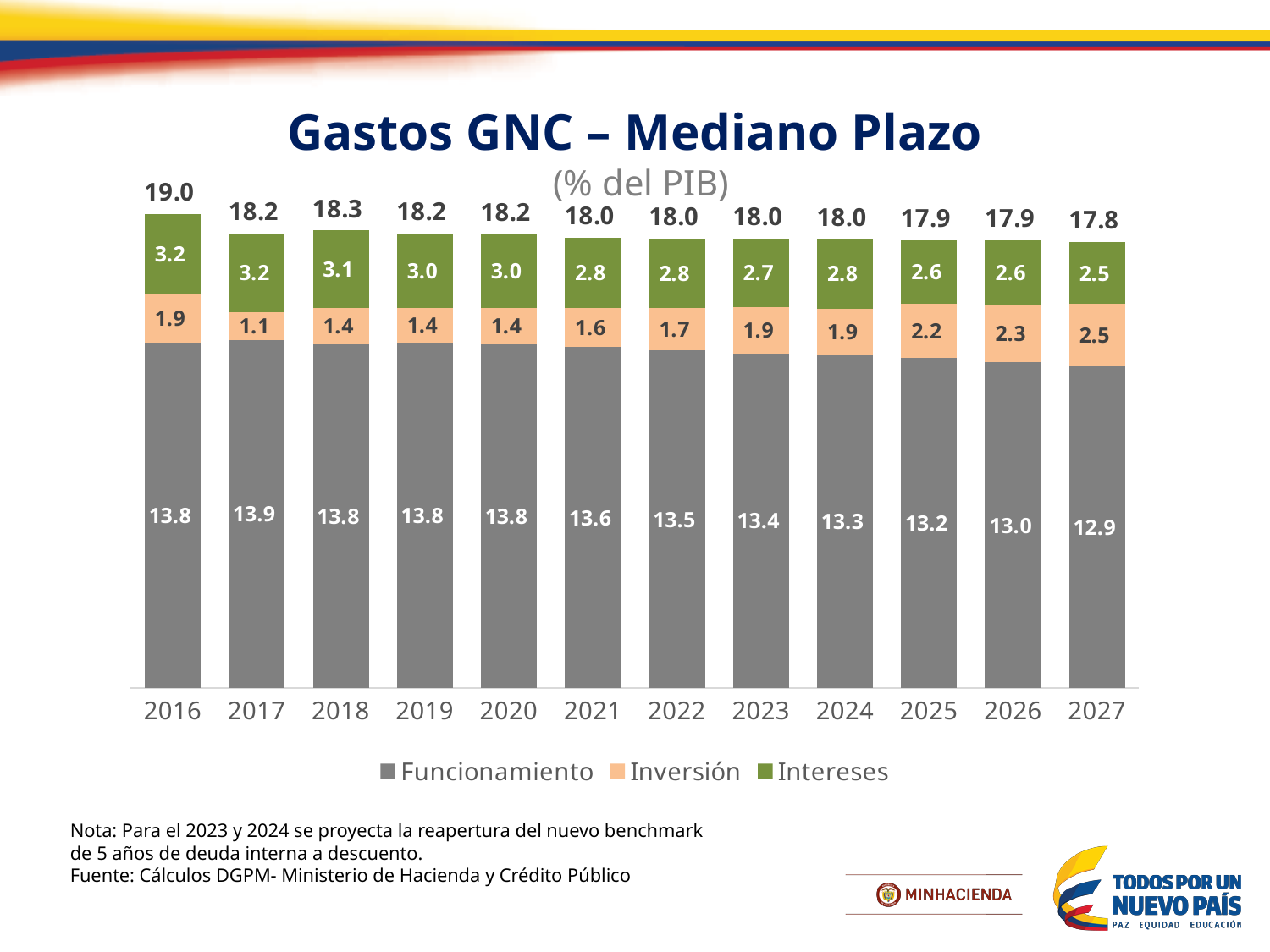
What is the Funcionamiento value for 2016? 13.8 How many series does the legend list? 3 Which year has the highest total value? 2016 Does the Funcionamiento value rise or fall from 2020 to 2027? Fall What is the Intereses value for 2023? 2.7 How many years are shown on the x axis? 12 Which is larger, the Inversión value for 2017 or the Inversión value for 2026? 2026 What is the total value printed above the bar for 2018? 18.3 What is the Inversión value for 2027? 2.5 What type of chart is shown on the slide? Stacked bar chart Which year has the lowest Funcionamiento value? 2027 What is the difference between the Intereses values for 2016 and 2027? 0.7